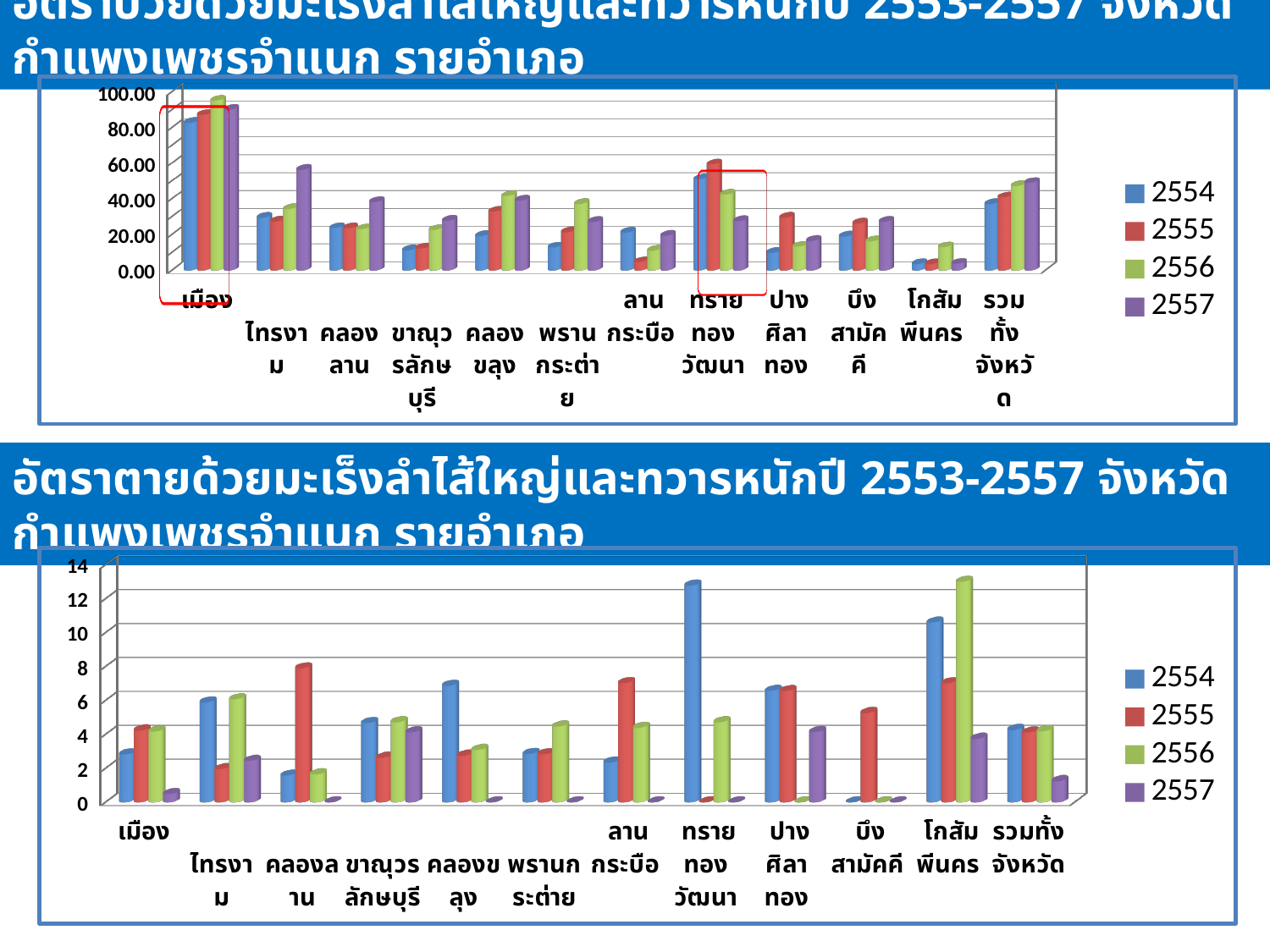
On the bottom chart, which legend entry is shown in purple? 2557 On the top chart, for ทรายทองวัฒนา, which is larger: the 2555 value or the 2557 value? 2555 On the bottom chart, which category has the highest value in the 2554 series? ทรายทองวัฒนา On the top chart, is the value for เมือง in 2554 greater or less than 80.00? greater On the top chart, which category has the highest values across all series? เมือง On the bottom chart, is the value for คลองลาน in 2555 greater or less than 6? greater On the top chart, is the value for โกสัมพีนคร in 2556 greater or less than 20.00? less On the top chart, how many series does the legend list? 4 On the bottom chart, what kind of chart is shown? bar chart On the bottom chart, for ไทรงาม, which is larger: the 2554 value or the 2555 value? 2554 On the bottom chart, which category has the highest value in the 2556 series? โกสัมพีนคร On the top chart, how many district categories are shown on the x axis? 11